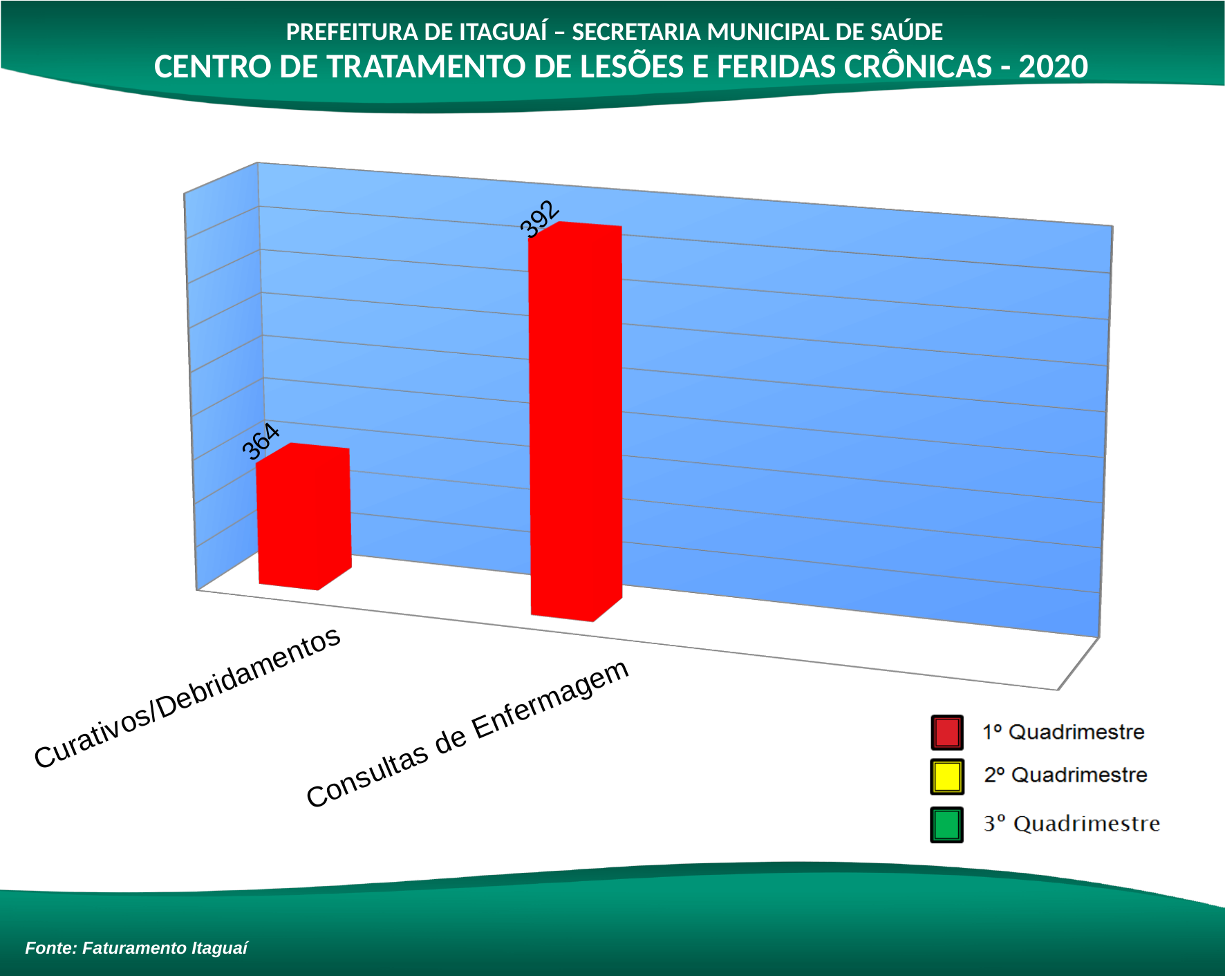
How many categories are shown on the x axis of the chart? 2 What is the value for Consultas de Enfermagem in the 1º Quadrimestre? 392 How many series does the legend list? 3 Which series is shown in yellow in the legend? 2º Quadrimestre What is the value for Curativos/Debridamentos in the 1º Quadrimestre? 364 What kind of chart is shown on the slide? Bar chart Which series is shown in red in the legend? 1º Quadrimestre Which is larger in the 1º Quadrimestre: Curativos/Debridamentos or Consultas de Enfermagem? Consultas de Enfermagem Which category has the highest value in the 1º Quadrimestre? Consultas de Enfermagem What is the difference between the 1º Quadrimestre values for Consultas de Enfermagem and Curativos/Debridamentos? 28 Which category has the lowest value in the 1º Quadrimestre? Curativos/Debridamentos